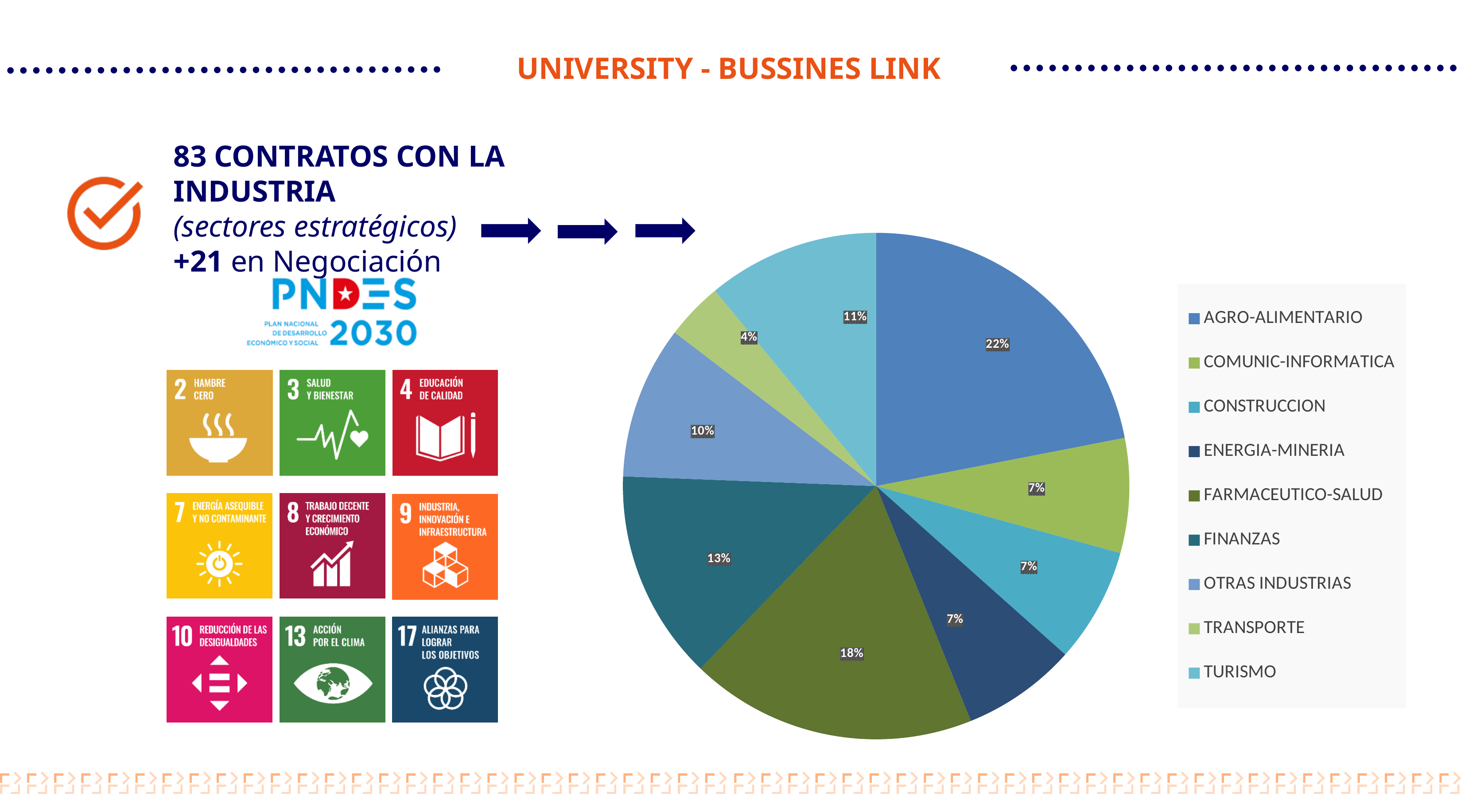
What is the difference in percentage points between AGRO-ALIMENTARIO and FARMACEUTICO-SALUD? 4 What share of the pie does FINANZAS represent? 13% How many categories does the pie chart legend list? 9 What share of the pie does OTRAS INDUSTRIAS represent? 10% Which category has the smallest slice of the pie? TRANSPORTE What kind of chart is shown on the slide? pie chart What share of the pie does AGRO-ALIMENTARIO represent? 22% Which category has the largest slice of the pie? AGRO-ALIMENTARIO Which is larger, the FINANZAS slice or the TURISMO slice? FINANZAS